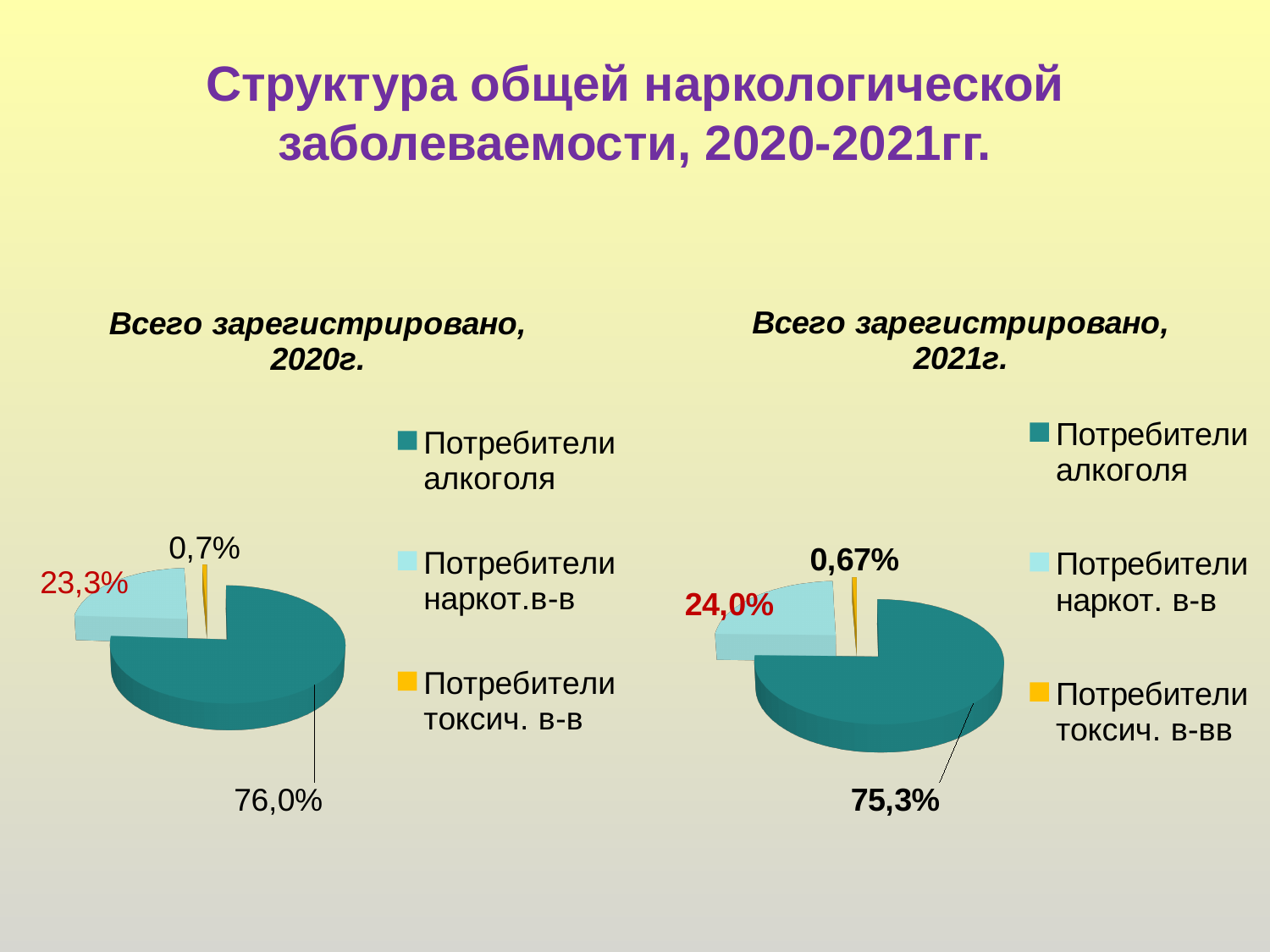
In the chart titled "Всего зарегистрировано, 2021г.", what is the value for Потребители токсич. в-вв? 0,67% How many categories does the chart titled "Всего зарегистрировано, 2020г." show? 3 What type of chart is the chart titled "Всего зарегистрировано, 2021г."? Pie chart In the chart titled "Всего зарегистрировано, 2020г.", what is the difference between the values for Потребители алкоголя and Потребители наркот.в-в? 52,7% In the chart titled "Всего зарегистрировано, 2020г.", what is the value for Потребители наркот.в-в? 23,3% In the chart titled "Всего зарегистрировано, 2020г.", what is the value for Потребители алкоголя? 76,0% In the chart titled "Всего зарегистрировано, 2021г.", which category has the largest share? Потребители алкоголя In the chart titled "Всего зарегистрировано, 2021г.", what is the value for Потребители наркот. в-в? 24,0% In the chart titled "Всего зарегистрировано, 2020г.", which category has the smallest share? Потребители токсич. в-в What is the title of the slide? Структура общей наркологической заболеваемости, 2020-2021гг. How many entries does the legend of the chart titled "Всего зарегистрировано, 2021г." list? 3 Which is larger: the value for Потребители алкоголя in the 2020 chart or in the 2021 chart? 2020 chart